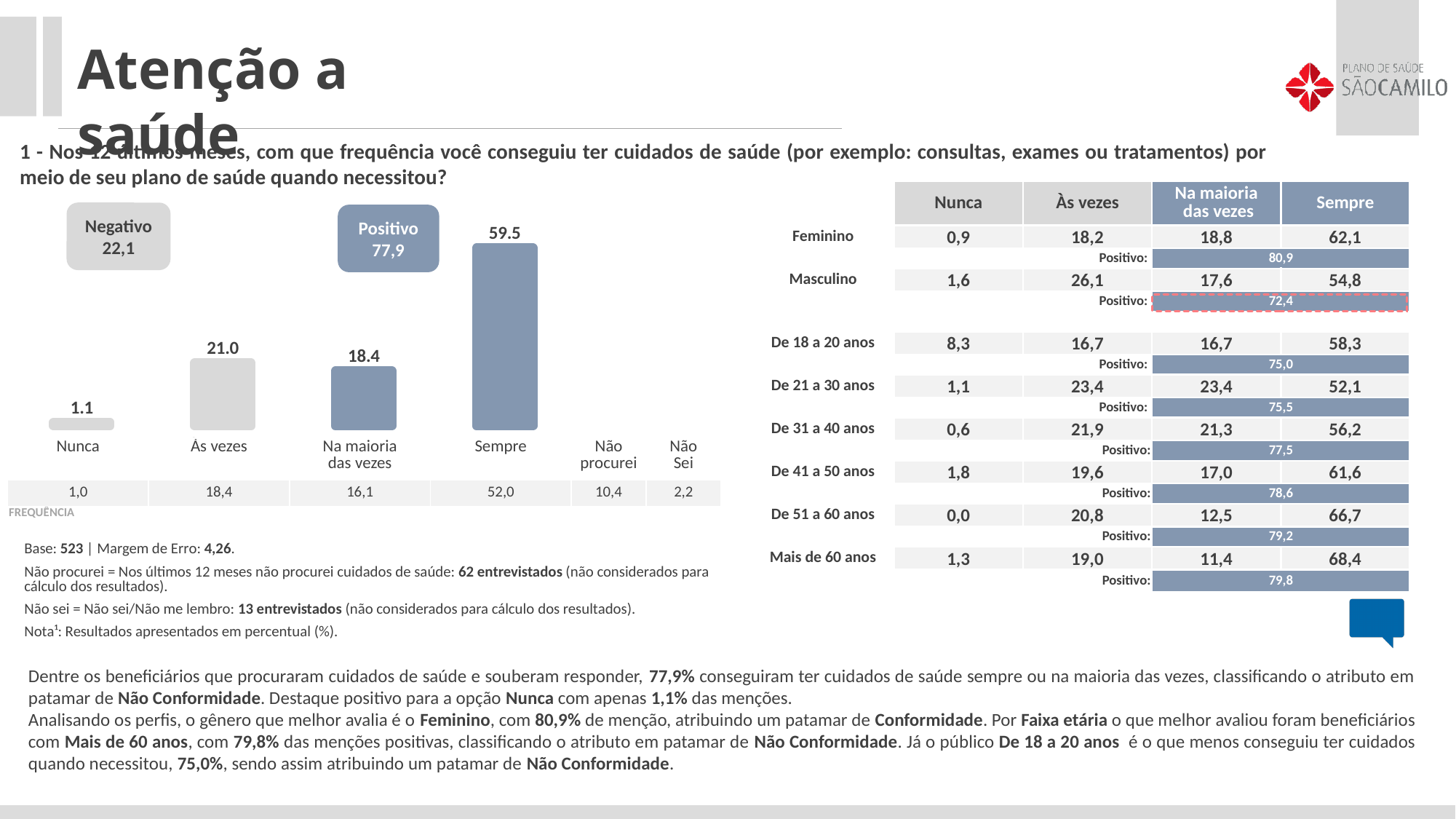
Which category has the lowest bar in the bar chart? Nunca Which category has the highest bar in the bar chart? Sempre What is the value of the Na maioria das vezes bar in the bar chart? 18.4 What is the difference between the Sempre bar and the Às vezes bar in the bar chart? 38.5 In the bar chart, which is larger: Às vezes or Na maioria das vezes? Às vezes What is the value of the Sempre bar in the bar chart? 59.5 What is the difference between the Às vezes bar and the Na maioria das vezes bar in the bar chart? 2.6 How many bars are plotted in the bar chart? 4 What is the value of the Às vezes bar in the bar chart? 21.0 What is the value of the Nunca bar in the bar chart? 1.1 What value is shown in the Positivo box above the bar chart? 77,9 What kind of chart is shown on the left of the slide? bar chart